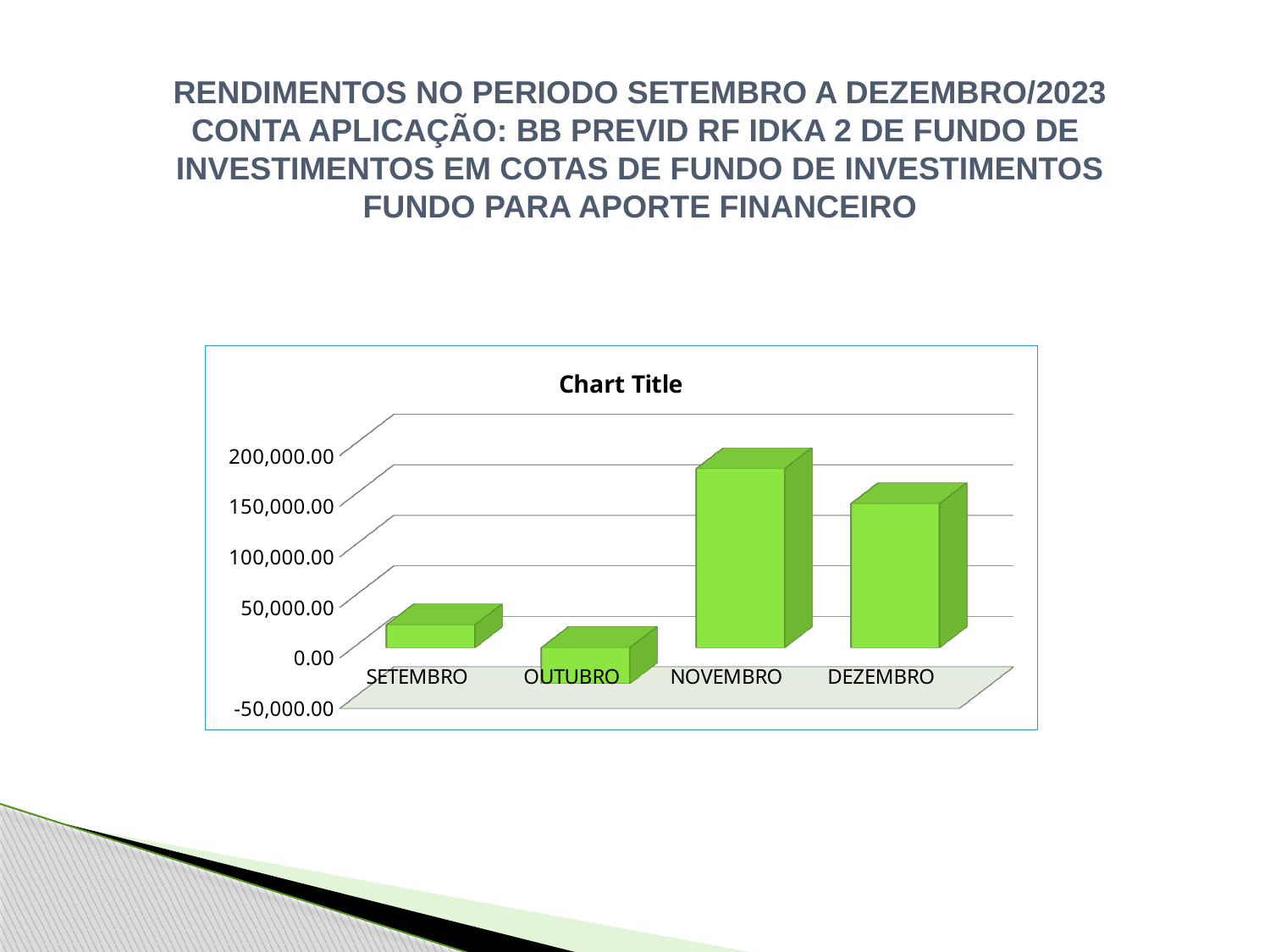
Is the value for NOVEMBRO greater or less than 150,000.00? greater What title is printed above the chart's plot area? Chart Title What kind of chart is shown on the slide? bar chart How many categories are plotted on the x axis of the chart? 4 Does the value rise or fall from NOVEMBRO to DEZEMBRO? fall Which is larger, the value for SETEMBRO or the value for OUTUBRO? SETEMBRO Which is larger, the value for NOVEMBRO or the value for DEZEMBRO? NOVEMBRO Is the value for OUTUBRO greater or less than 0.00? less Which month has the lowest value in the chart? OUTUBRO Which month has the highest value in the chart? NOVEMBRO Is the value for SETEMBRO greater or less than 50,000.00? less